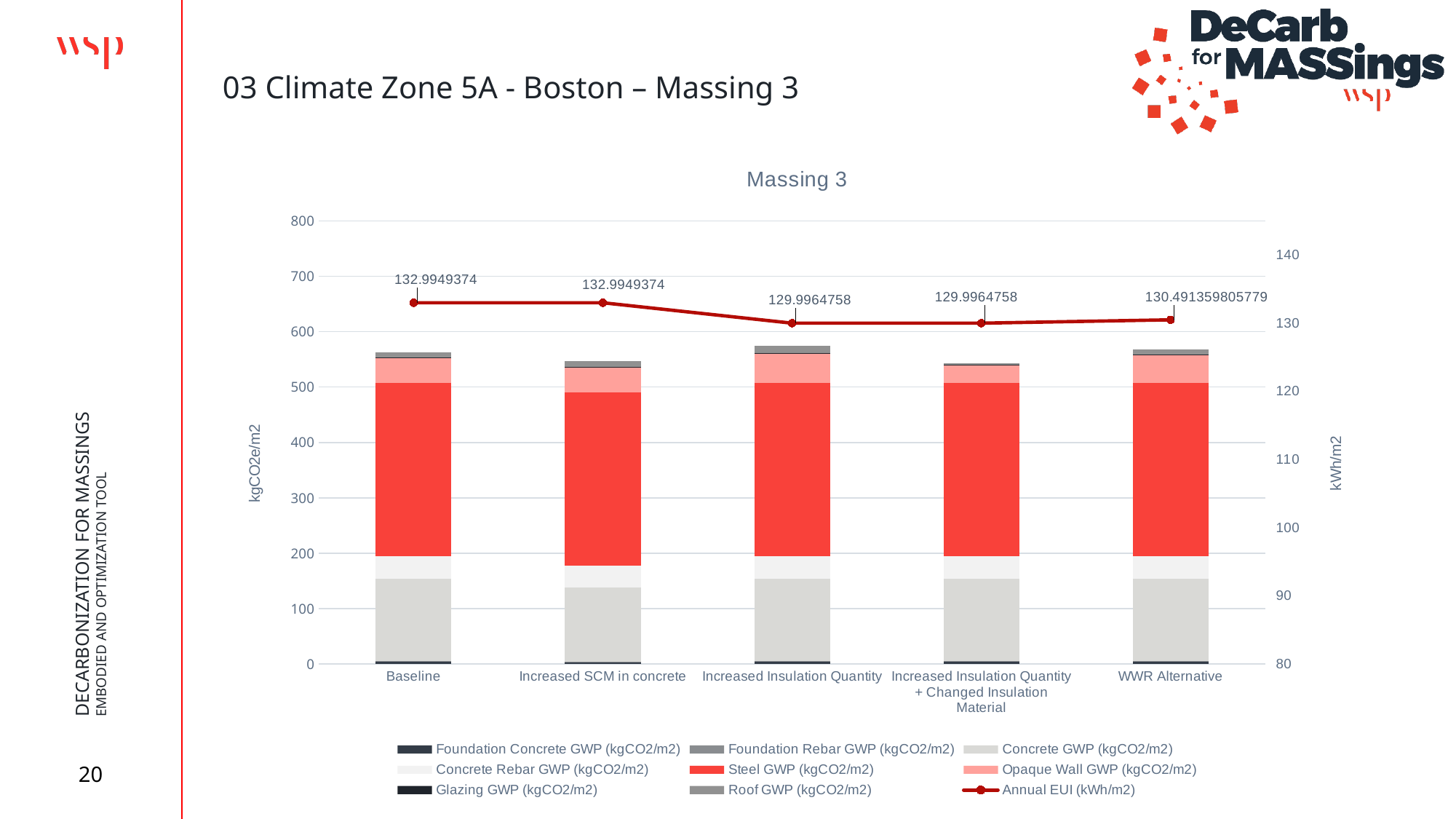
What kind of chart is this? Stacked bar chart with a line How many series does the legend list? 9 Does the Annual EUI line rise or fall from Baseline to Increased Insulation Quantity? fall What is the Annual EUI (kWh/m2) value for WWR Alternative? 130.491359805779 Is the total stacked bar value for Increased SCM in concrete greater or less than 600? less Which has the larger Annual EUI value, Baseline or Increased Insulation Quantity? Baseline Is the total stacked bar value for Baseline greater or less than 500? greater How many categories are shown on the x axis? 5 What is the Annual EUI (kWh/m2) value for Baseline? 132.9949374 What is the difference between the Annual EUI values for Baseline and Increased Insulation Quantity? 2.9984616 What is the title of the chart? Massing 3 What is the Annual EUI (kWh/m2) value for Increased Insulation Quantity? 129.9964758